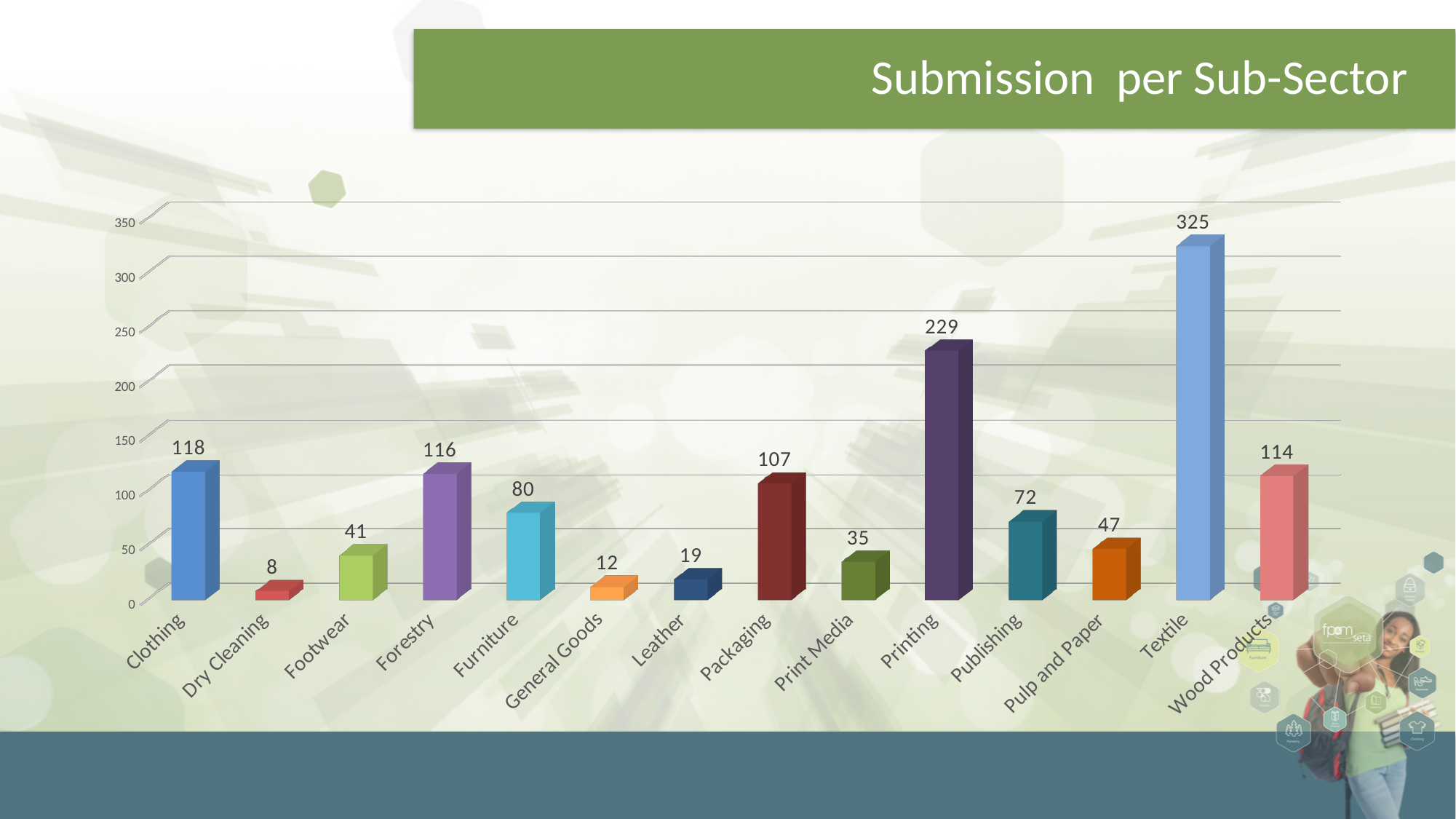
What kind of chart is shown on the slide? Bar chart How many sub-sectors are shown on the chart? 14 What is the difference between the values for Textile and Printing? 96 What is the title of the slide? Submission per Sub-Sector What is the value for Textile? 325 Which is larger, the value for Furniture or the value for Publishing? Furniture What is the difference between the values for Clothing and Wood Products? 4 What is the value for Pulp and Paper? 47 What is the value for Packaging? 107 Is the value for Printing greater or less than 200? greater Which sub-sector has the lowest value? Dry Cleaning Which sub-sector has the highest value? Textile